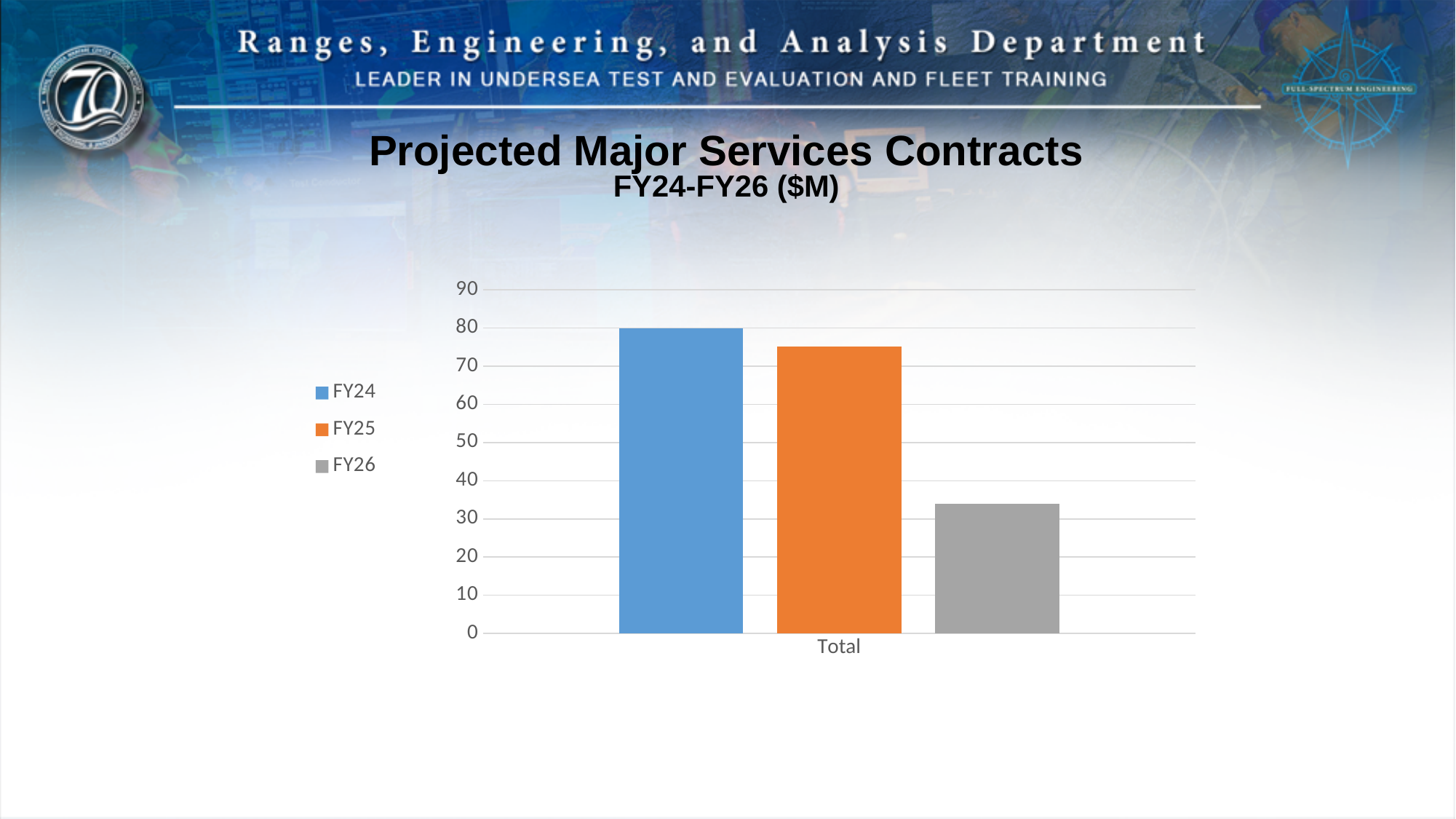
What kind of chart is shown on the slide? bar chart What is the title of the chart? Projected Major Services Contracts FY24-FY26 ($M) What colour is the FY25 bar? orange Is the value for FY26 greater or less than 30? greater Is the value for FY25 greater or less than 70? greater How many series does the legend list? 3 How many categories are shown on the x axis? 1 Is the value for FY26 greater or less than 40? less Which is larger, the FY24 bar or the FY25 bar? FY24 Which series has the highest bar? FY24 What is the value of the FY24 bar? 80 Which series has the lowest bar? FY26